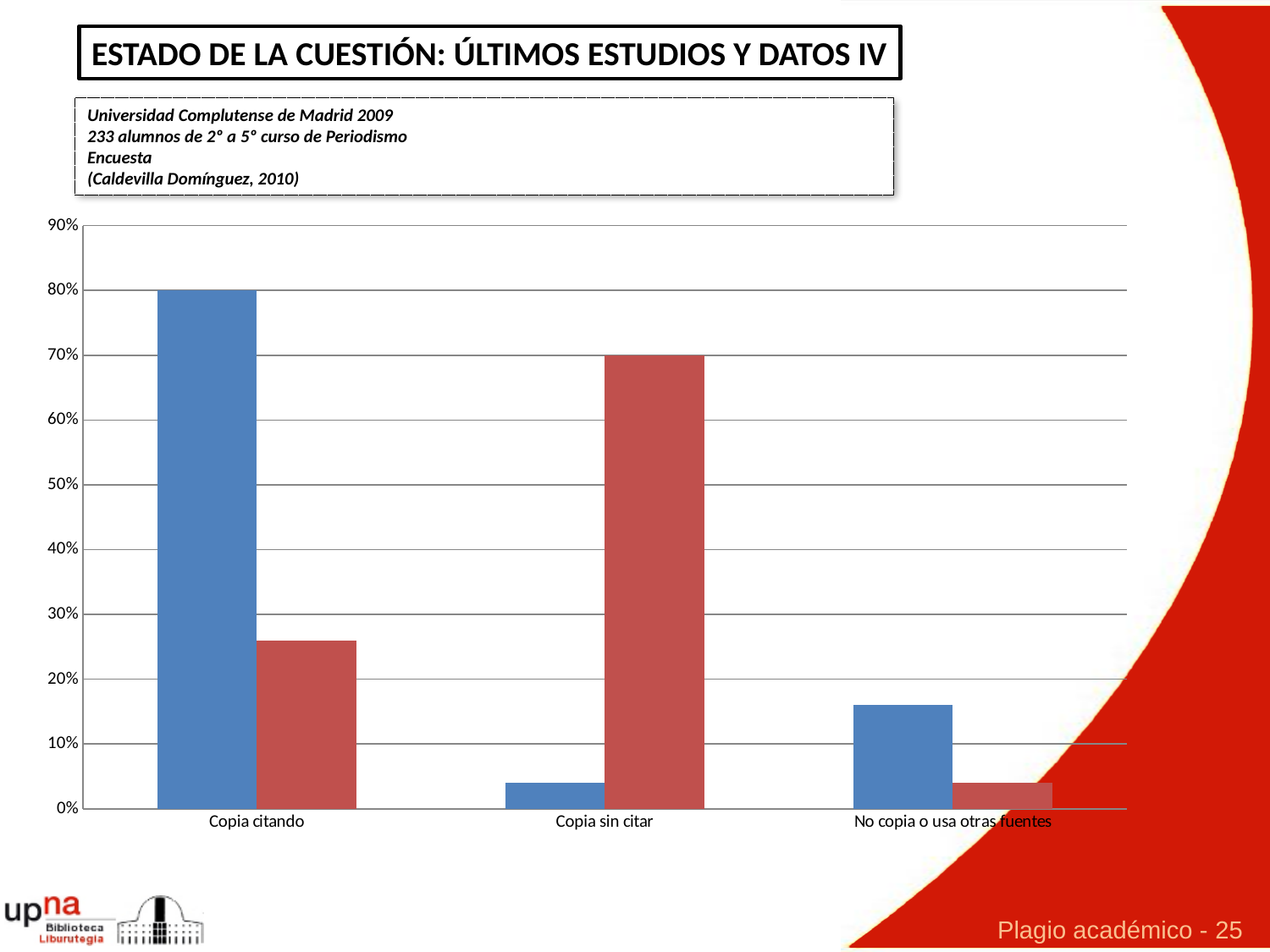
For "Copia sin citar", which bar is larger, the blue one or the red one? the red one Which category has the highest red bar? Copia sin citar Is the blue bar for "No copia o usa otras fuentes" greater or less than 10%? greater Which category has the highest blue bar? Copia citando What is the value of the blue bar for "Copia citando"? 80% Which category has the lowest red bar? No copia o usa otras fuentes How many categories are shown on the x axis of the chart? 3 What is the value of the red bar for "Copia sin citar"? 70% What is the highest value shown on the y axis of the chart? 90% Which category has the lowest blue bar? Copia sin citar Is the red bar for "Copia citando" greater or less than 30%? less What kind of chart is shown on the slide? bar chart